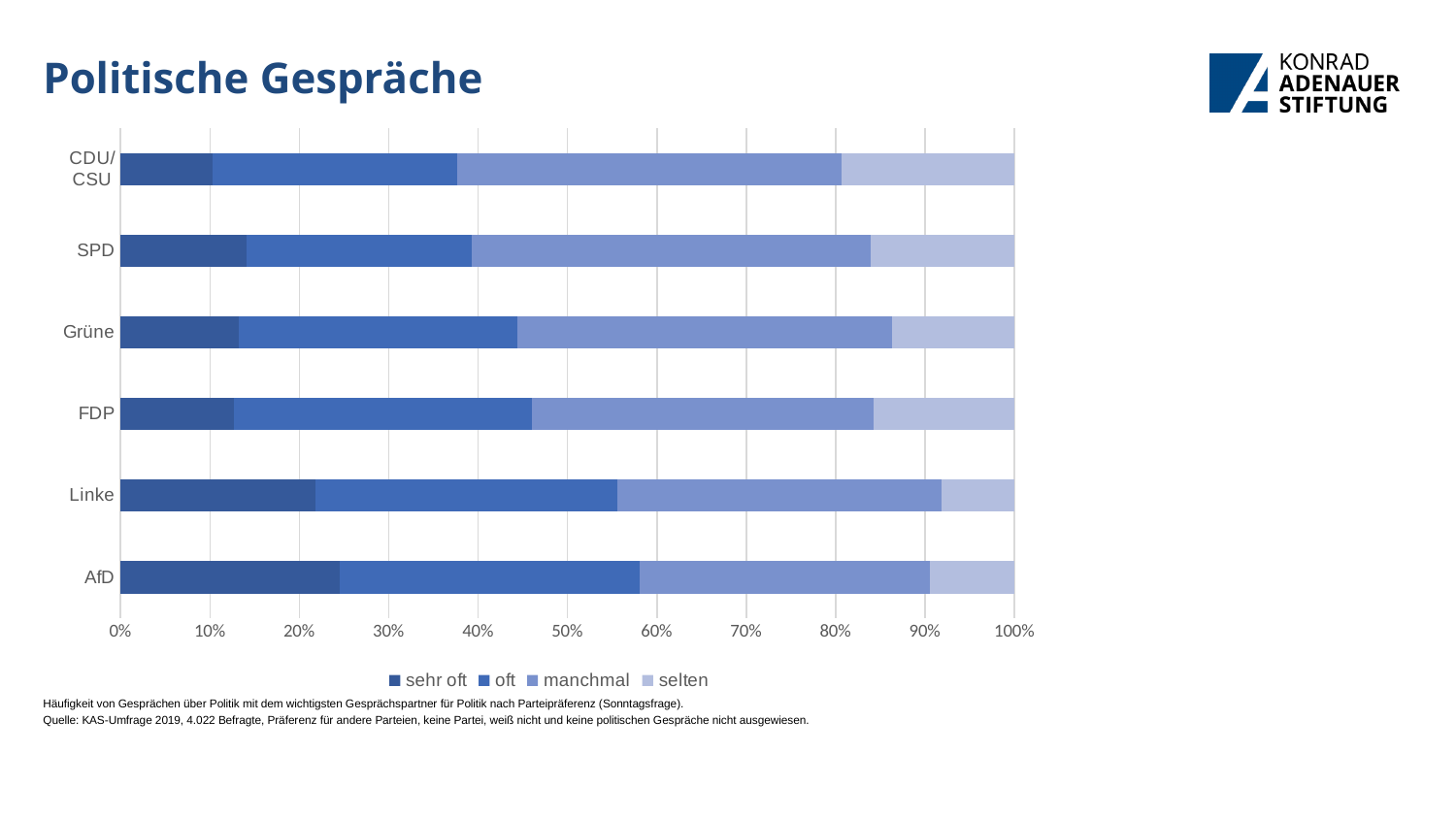
How many parties (categories) are shown on the chart? 6 Which party has the smallest 'sehr oft' segment? CDU/CSU What is the title of the slide? Politische Gespräche Is the 'sehr oft' value for Linke greater or less than 20%? greater Is the 'sehr oft' value for SPD greater or less than 20%? less What kind of chart is shown on the slide? stacked bar chart Which party has the largest 'sehr oft' segment? AfD Is the 'sehr oft' segment larger for Linke or for SPD? Linke What does each stacked bar total on the x axis? 100% Which party has the largest 'selten' segment? CDU/CSU How many series does the legend list? 4 Which series is listed last in the legend? selten